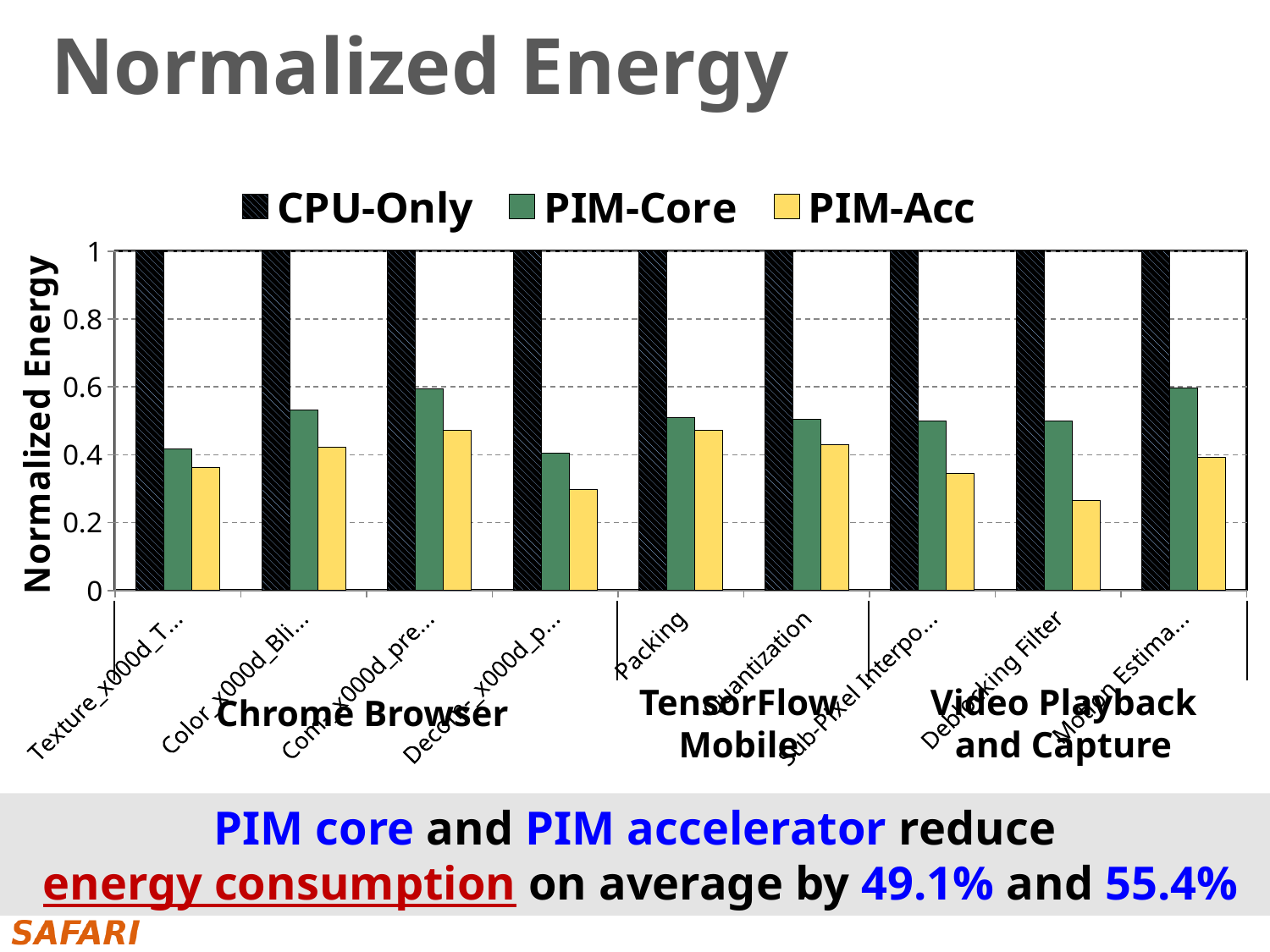
Is the PIM-Acc value for Deblocking Filter greater or less than 0.4? less How many series does the legend list? 3 What kind of chart is shown on the slide? bar chart How many categories (workloads) are plotted along the x axis? 9 What is the normalized energy value for CPU-Only for Packing? 1 Is the PIM-Core value for Deblocking Filter greater or less than 0.4? greater What are the three series named in the legend? CPU-Only, PIM-Core, PIM-Acc Is the PIM-Acc value for Packing greater or less than 0.4? greater What is the title of the y axis? Normalized Energy For Deblocking Filter, which is larger: the PIM-Core value or the PIM-Acc value? PIM-Core What is the normalized energy value for CPU-Only for Deblocking Filter? 1